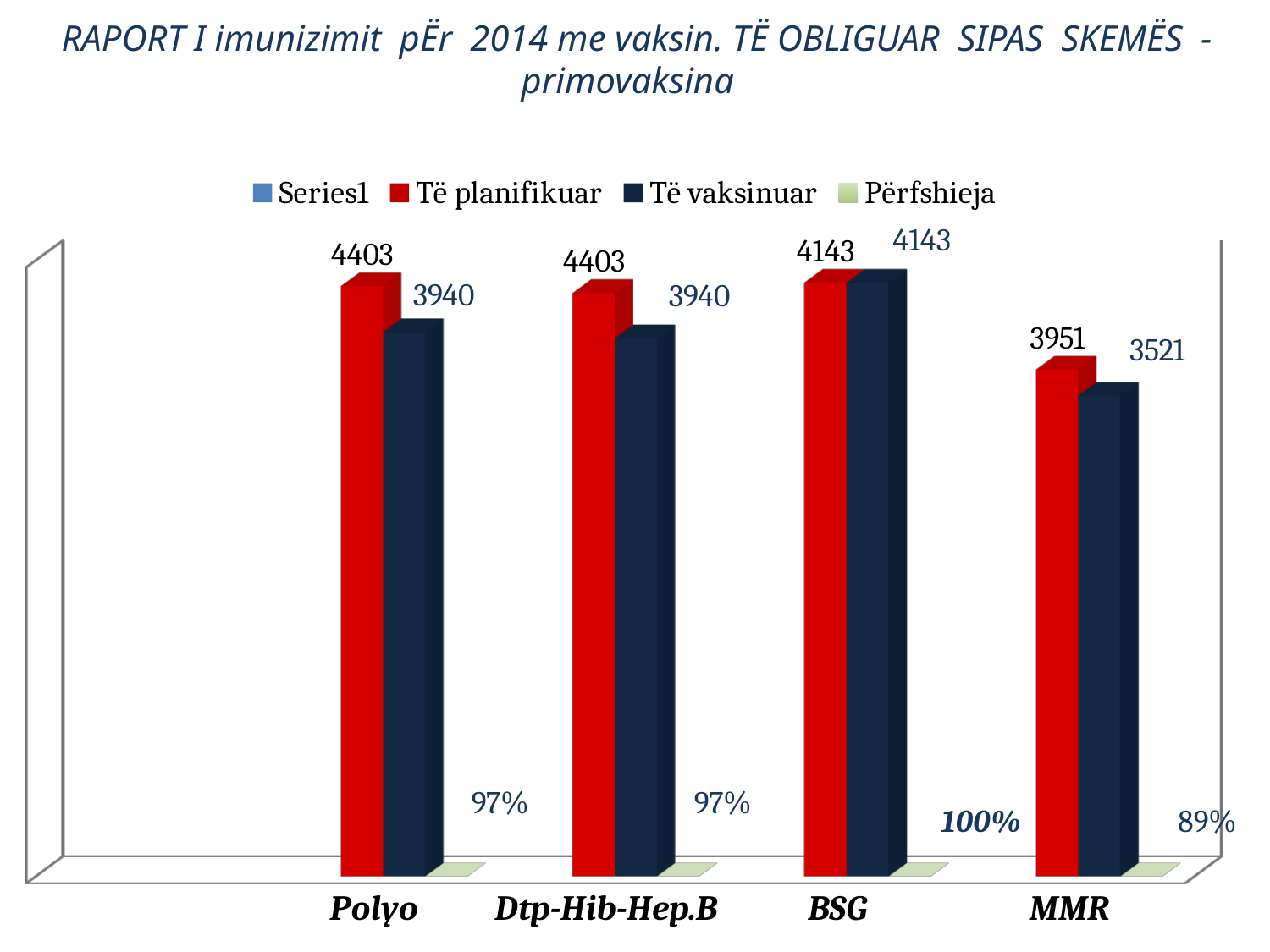
How many categories are shown on the x axis? 4 What is the 'Të vaksinuar' value for Dtp-Hib-Hep.B? 3940 Which category has the lowest 'Të vaksinuar' value? MMR What is the 'Të planifikuar' value for Polyo? 4403 What kind of chart is shown on the slide? Bar chart What is the difference between 'Të planifikuar' and 'Të vaksinuar' for MMR? 430 What is the 'Të vaksinuar' value for MMR? 3521 What is the 'Përfshieja' percentage shown for BSG? 100% Which category has the lowest 'Përfshieja' percentage? MMR How many series does the legend list? 4 Which is larger: the 'Të vaksinuar' value for BSG or the 'Të vaksinuar' value for Polyo? BSG What is the difference between 'Të planifikuar' and 'Të vaksinuar' for Polyo? 463